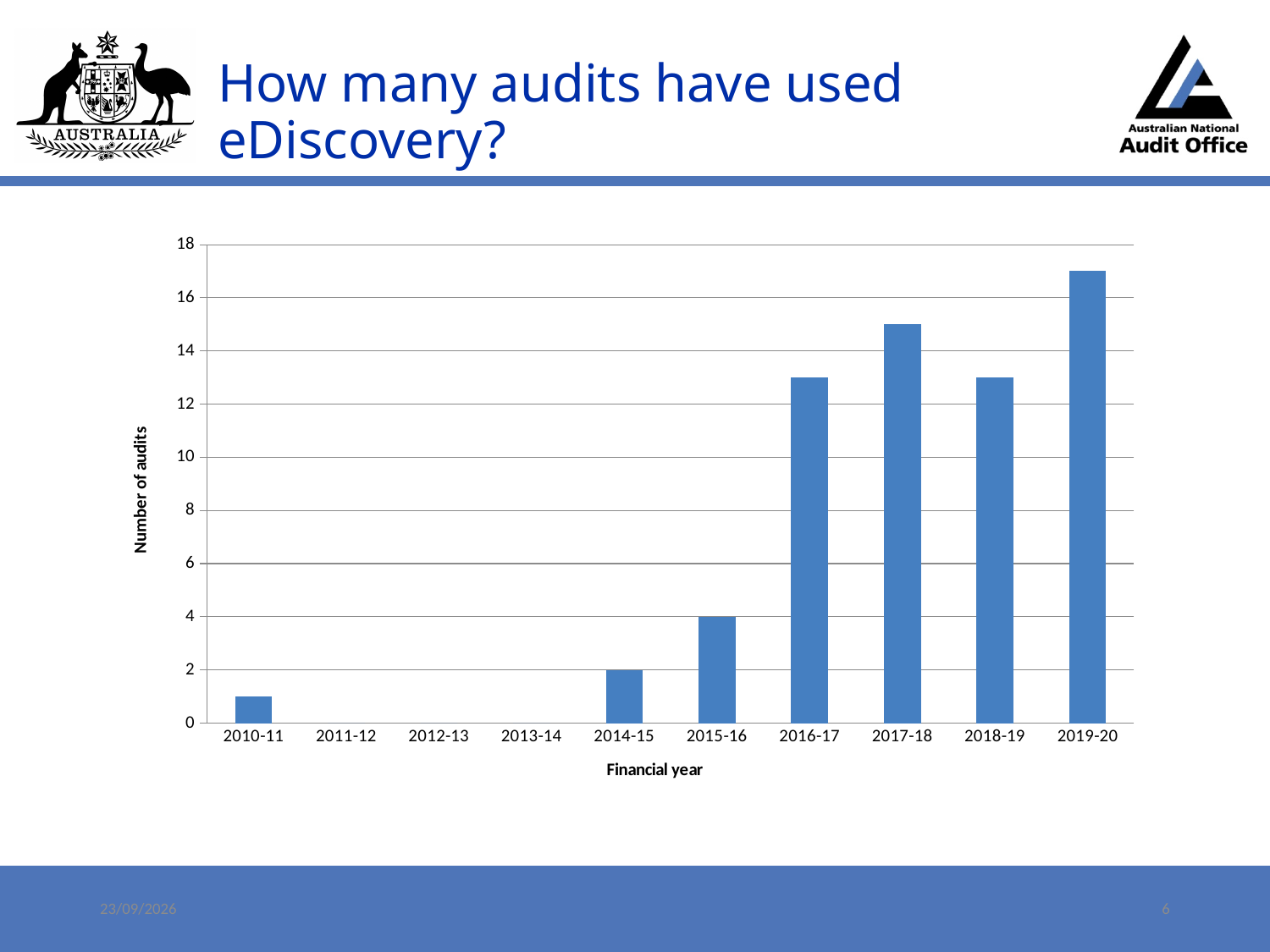
Which has more audits, 2019-20 or 2017-18? 2019-20 What is the number of audits for 2015-16? 4 What is the number of audits for 2014-15? 2 Which financial year has the highest number of audits? 2019-20 How many financial years are shown on the x axis of the chart? 10 What kind of chart is shown on the slide? bar chart Which has more audits, 2017-18 or 2016-17? 2017-18 Is the value for 2010-11 greater or less than 2? less Do the number of audits generally rise or fall from 2010-11 to 2019-20? rise Is the value for 2019-20 greater or less than 16? greater What is the label on the vertical axis of the chart? Number of audits What is the difference in the number of audits between 2015-16 and 2014-15? 2